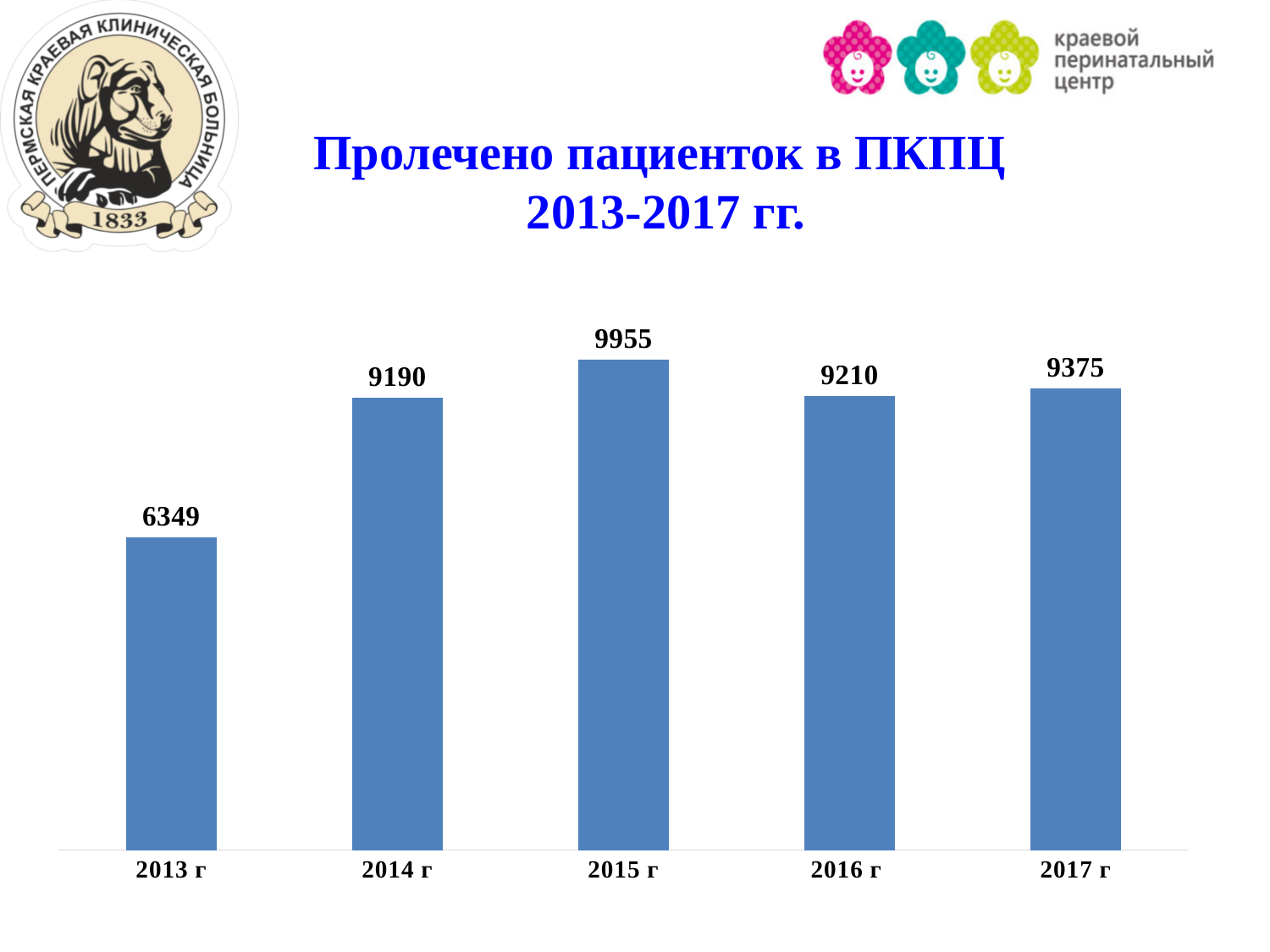
What value is shown for 2015 г? 9955 What is the difference between the values for 2017 г and 2016 г? 165 Which is larger, the value for 2014 г or the value for 2017 г? 2017 г Which year has the lowest value? 2013 г What value is shown for 2017 г? 9375 How many years are shown on the chart? 5 Does the value rise or fall from 2013 г to 2014 г? rise What kind of chart is shown on the slide? bar chart Which year has the highest value? 2015 г What value is shown for 2013 г? 6349 What is the title of the chart? Пролечено пациенток в ПКПЦ 2013-2017 гг. What is the difference between the values for 2015 г and 2013 г? 3606